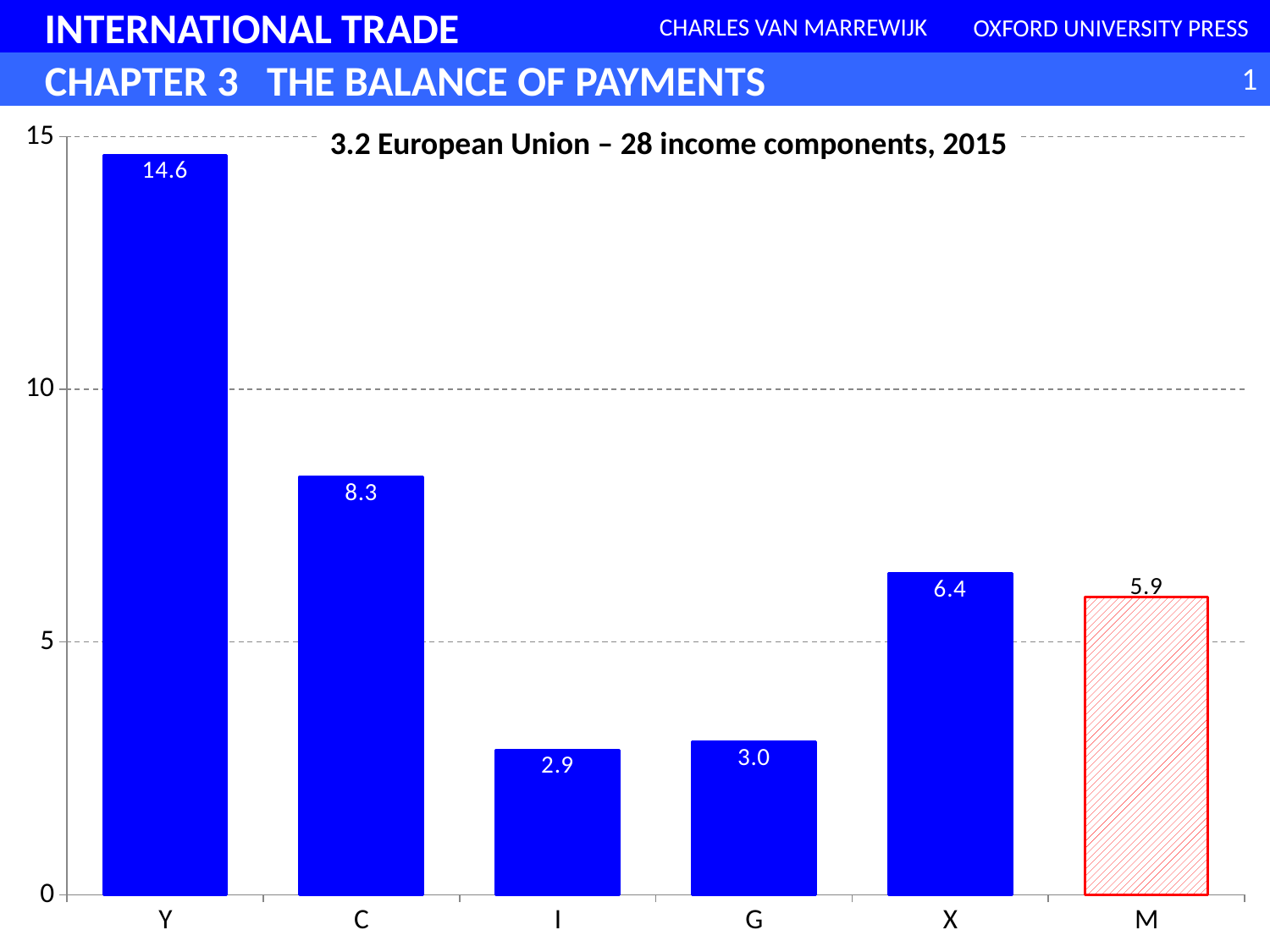
What is the value for Y? 14.6 Which is larger, the value for C or the value for X? C What kind of chart is shown? bar chart Is the value for G greater or less than 5? less What is the difference between the values for Y and C? 6.3 What is the value for C? 8.3 Which category has the highest value? Y Which category has the lowest value? I What is the difference between the values for X and M? 0.5 What is the value for M? 5.9 What is the title of the chart? 3.2 European Union – 28 income components, 2015 How many categories are shown on the x axis? 6